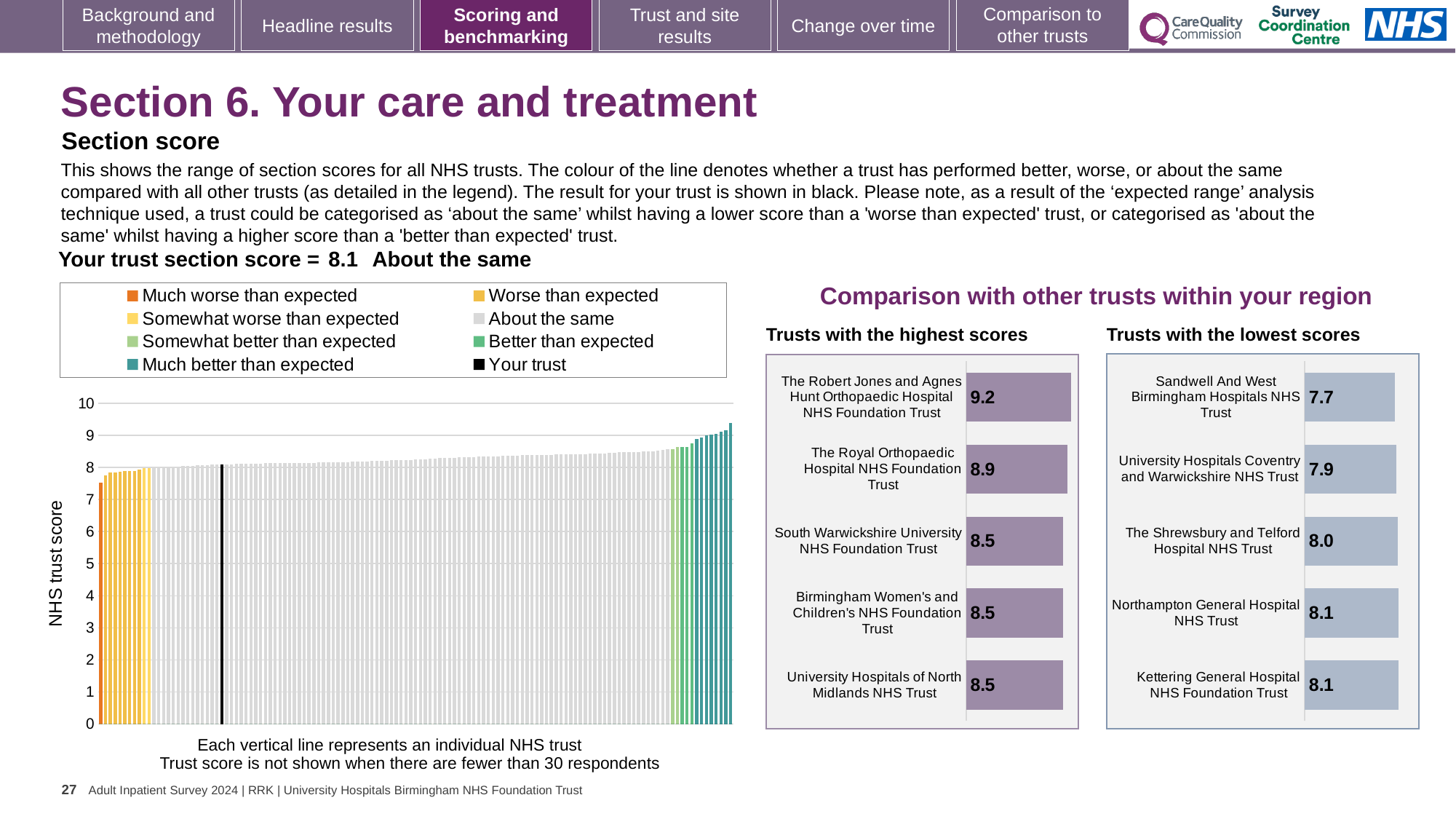
In the 'Trusts with the lowest scores' chart, which trust has the lowest score? Sandwell And West Birmingham Hospitals NHS Trust What is the label on the vertical axis of the main chart on the left? NHS trust score In the 'Trusts with the lowest scores' chart, which has the higher score: The Shrewsbury and Telford Hospital NHS Trust or Northampton General Hospital NHS Trust? Northampton General Hospital NHS Trust In the 'Trusts with the lowest scores' chart, what is the score for Sandwell And West Birmingham Hospitals NHS Trust? 7.7 How many entries does the legend of the main 'NHS trust score' chart on the left list? 8 According to the slide, what is your trust's section score shown in the main chart on the left? 8.1 In the 'Trusts with the lowest scores' chart, what is the difference between the scores of University Hospitals Coventry and Warwickshire NHS Trust and Sandwell And West Birmingham Hospitals NHS Trust? 0.2 In the 'Trusts with the highest scores' chart, which trust has the highest score? The Robert Jones and Agnes Hunt Orthopaedic Hospital NHS Foundation Trust In the 'Trusts with the highest scores' chart, what is the score for The Robert Jones and Agnes Hunt Orthopaedic Hospital NHS Foundation Trust? 9.2 How many trusts are listed in the 'Trusts with the highest scores' chart? 5 In the 'Trusts with the highest scores' chart, what is the difference between the scores of The Robert Jones and Agnes Hunt Orthopaedic Hospital NHS Foundation Trust and The Royal Orthopaedic Hospital NHS Foundation Trust? 0.3 What kind of chart is the 'Trusts with the highest scores' chart? bar chart